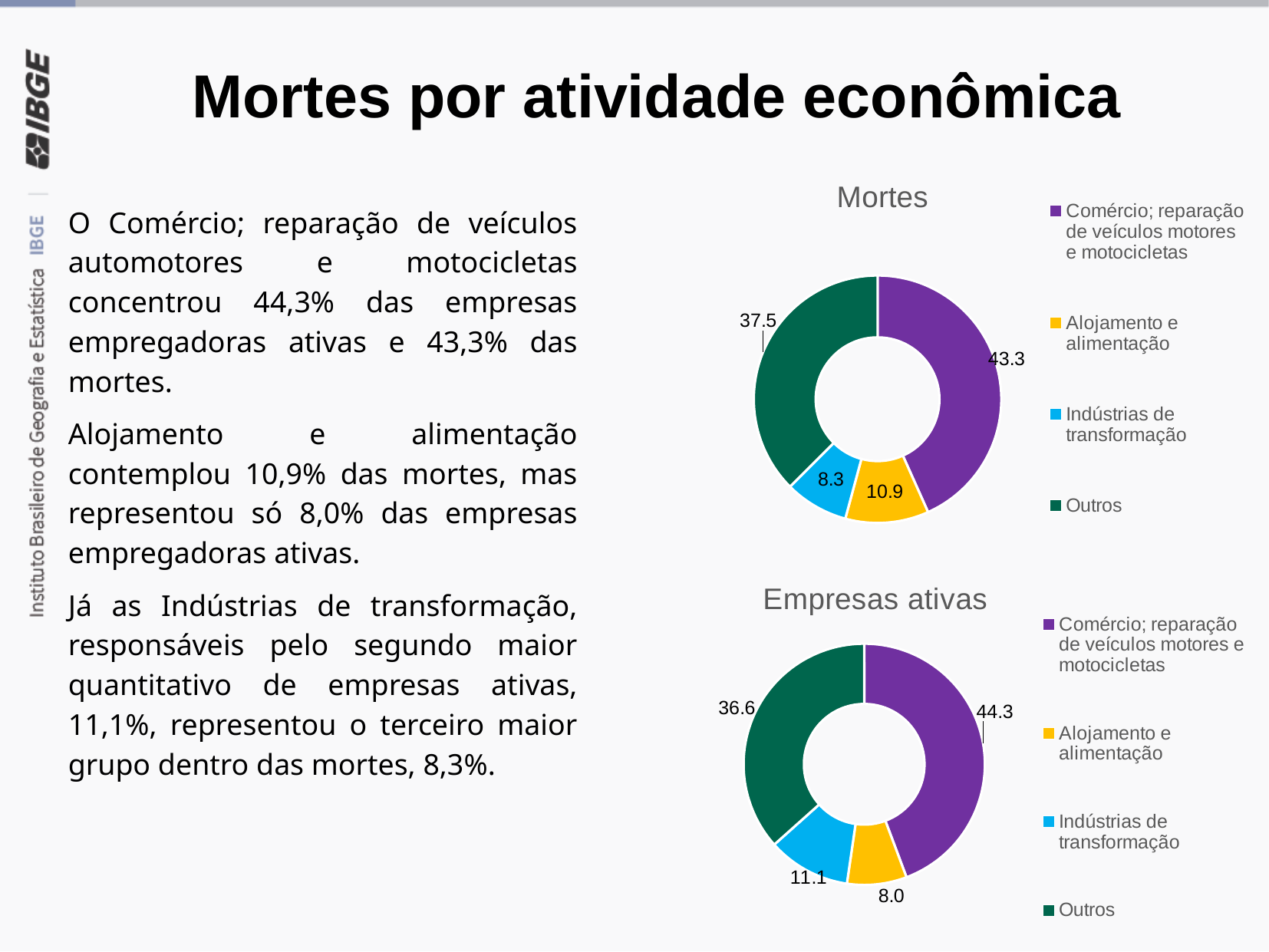
In the 'Empresas ativas' chart, what is the difference between the values for Indústrias de transformação and Alojamento e alimentação? 3.1 In the 'Mortes' chart, what is the value for Alojamento e alimentação? 10.9 In the 'Mortes' chart, which category has the smallest slice? Indústrias de transformação In the 'Empresas ativas' chart, which category has the largest slice? Comércio; reparação de veículos motores e motocicletas What kind of chart is the 'Mortes' chart? Doughnut (pie) chart In the 'Mortes' chart, which is larger: the value for Alojamento e alimentação or the value for Indústrias de transformação? Alojamento e alimentação In the 'Empresas ativas' chart, what is the value for Indústrias de transformação? 11.1 In the 'Empresas ativas' chart, which category has the smallest slice? Alojamento e alimentação How many categories does the 'Empresas ativas' chart show? 4 In the 'Mortes' chart, what is the value for Outros? 37.5 In the 'Mortes' chart, what is the difference between the values for Comércio; reparação de veículos motores e motocicletas and Outros? 5.8 In the 'Empresas ativas' chart, what colour is the slice for Outros? Dark green